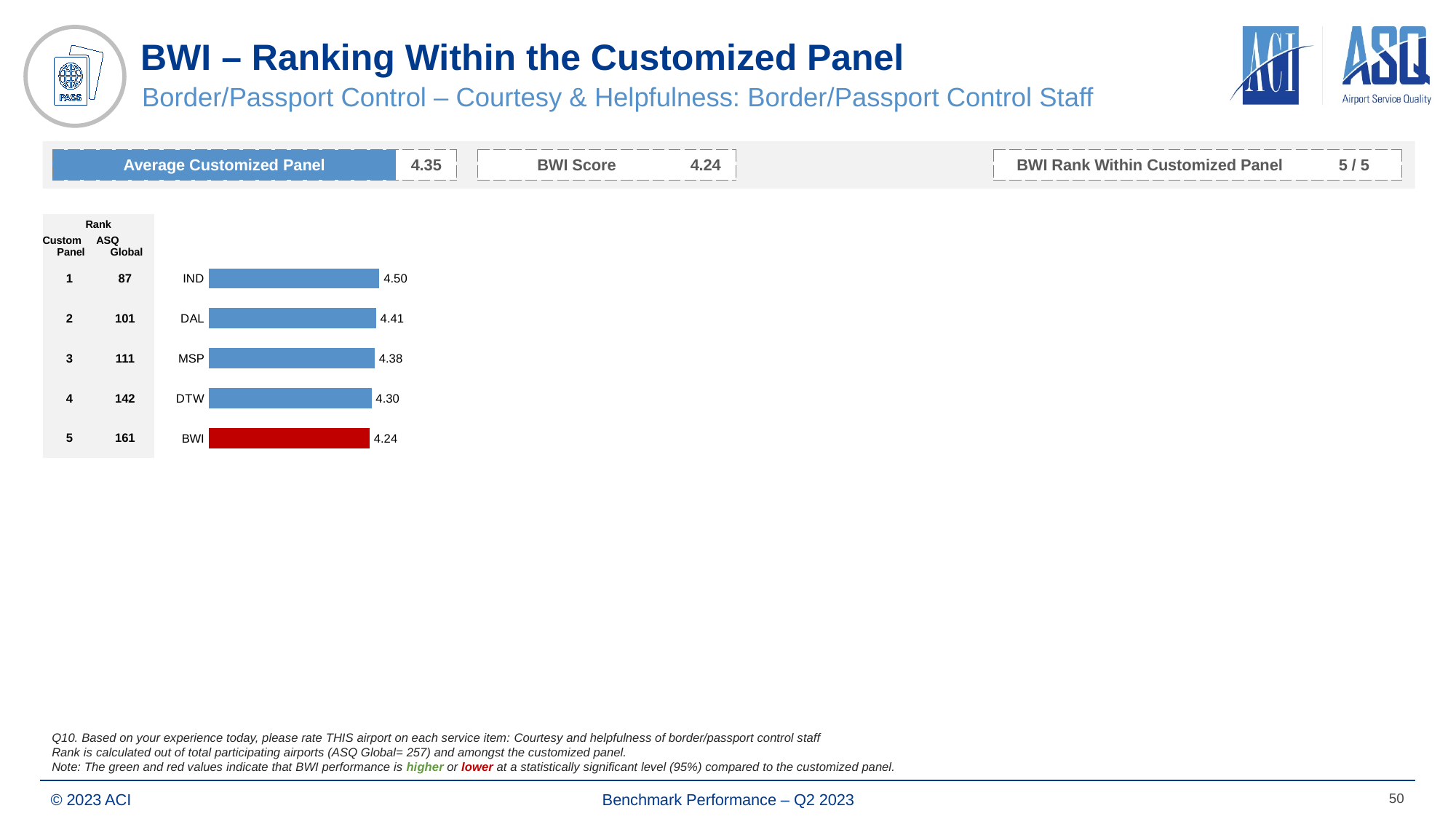
Which bar is coloured red? BWI What is the difference between the values for DAL and DTW? 0.11 What is the Average Customized Panel score shown on the slide? 4.35 What is the value for MSP? 4.38 What is the value for IND? 4.50 Which airport has the highest value? IND What is the value for BWI? 4.24 How many airports are shown in the chart? 5 Which is larger, the value for DAL or the value for MSP? DAL What is the difference between the values for IND and BWI? 0.26 Which airport has the lowest value? BWI What kind of chart is shown? Bar chart